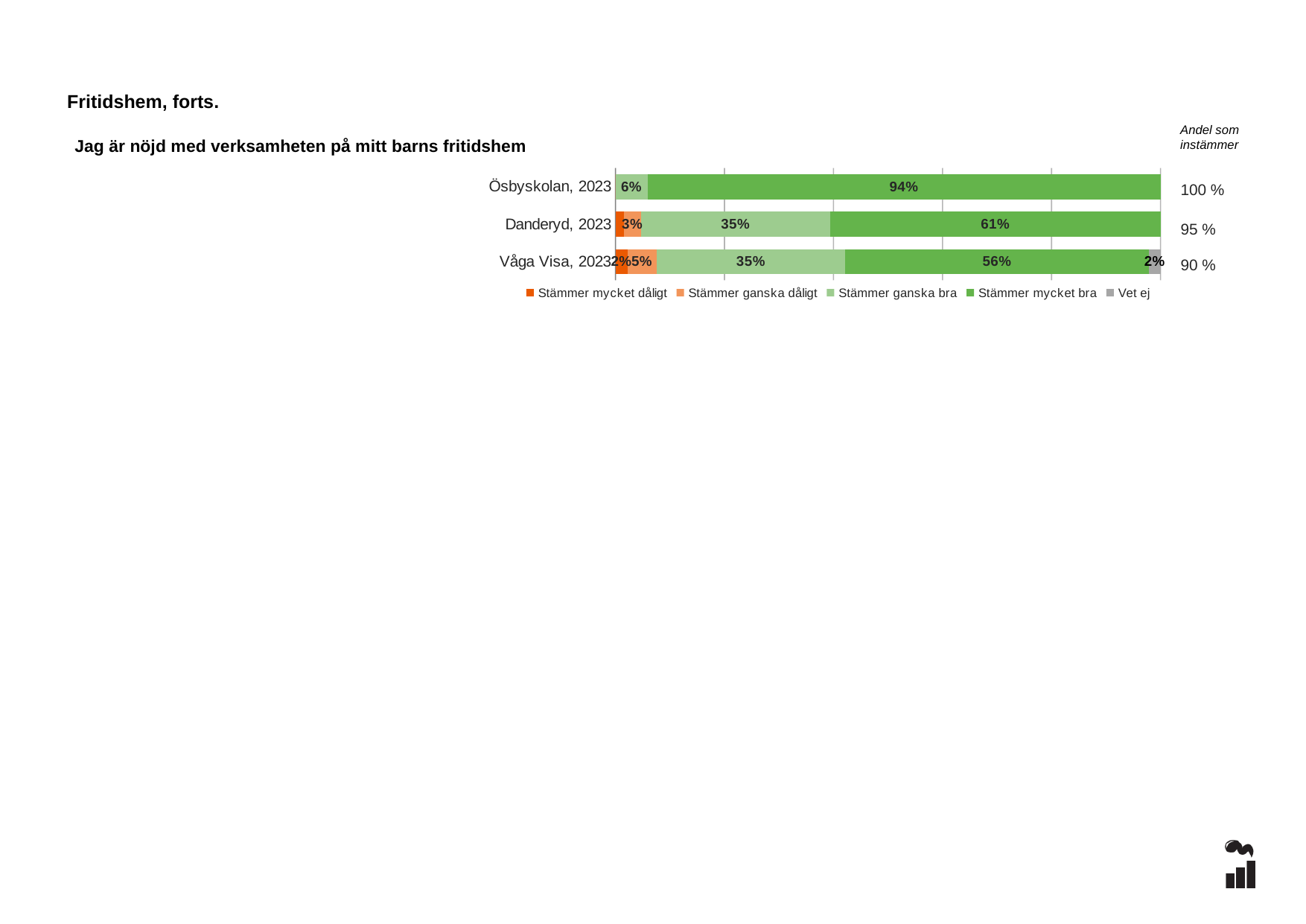
Which category has the highest value for "Stämmer mycket bra"? Ösbyskolan, 2023 What kind of chart is shown on the slide? Stacked bar chart What is the "Andel som instämmer" value shown for Danderyd, 2023? 95 % How many series does the legend list? 5 What is the value of "Stämmer mycket bra" for Ösbyskolan, 2023? 94% What is the value of "Stämmer mycket bra" for Våga Visa, 2023? 56% How many categories (rows) are plotted in the chart? 3 What is the difference between the "Stämmer mycket bra" values for Danderyd, 2023 and Våga Visa, 2023? 5% What is the value of "Stämmer ganska bra" for Danderyd, 2023? 35% What is the title of the chart? Jag är nöjd med verksamheten på mitt barns fritidshem What is the value of "Vet ej" for Våga Visa, 2023? 2% Which is larger: "Stämmer ganska dåligt" for Danderyd, 2023 or for Våga Visa, 2023? Våga Visa, 2023